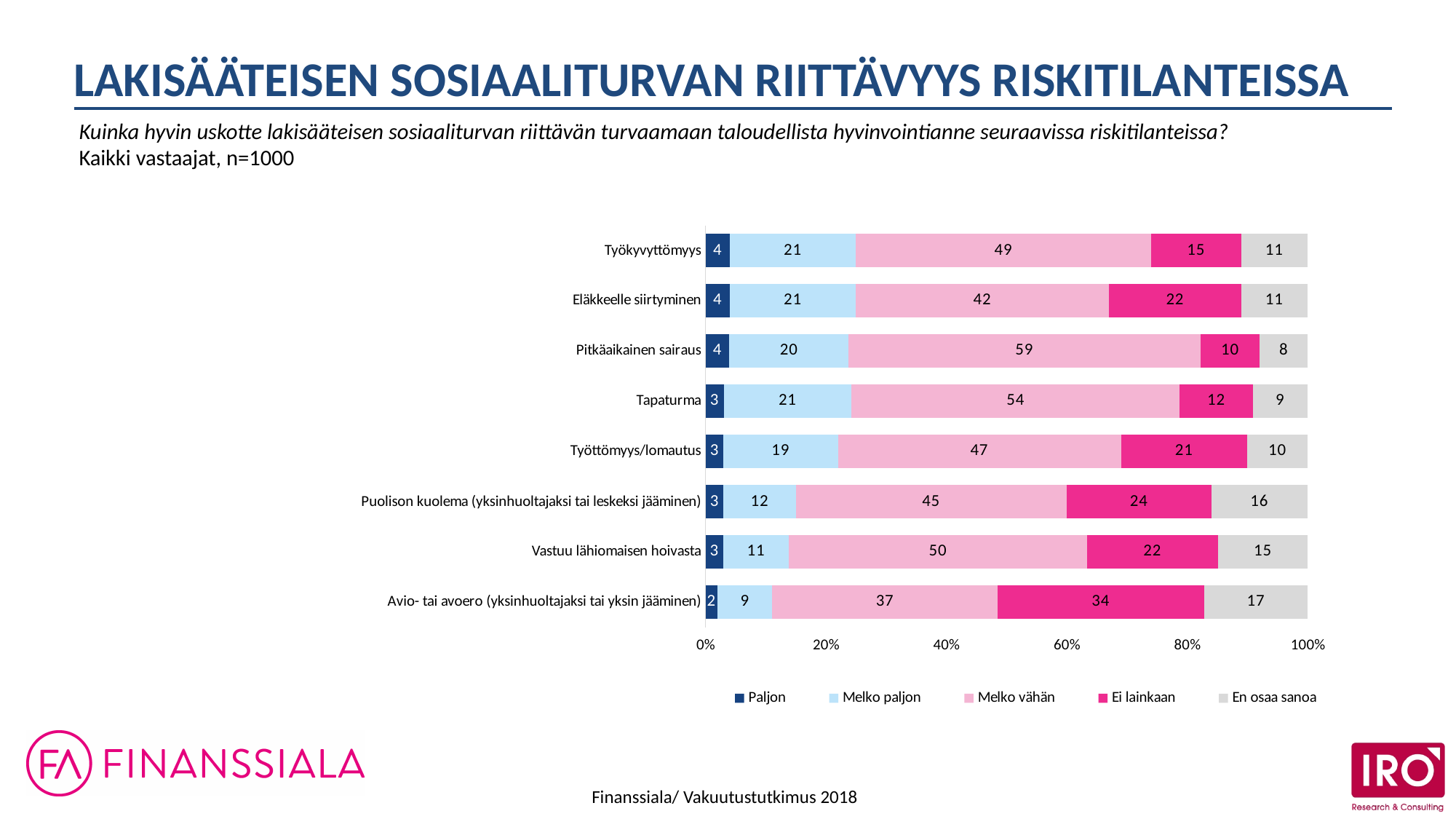
How many categories are shown on the chart? 8 What is the value of "En osaa sanoa" for Puolison kuolema (yksinhuoltajaksi tai leskeksi jääminen)? 16 What is the difference between the "Melko vähän" values for Pitkäaikainen sairaus and Eläkkeelle siirtyminen? 17 How many series does the legend list? 5 What kind of chart is shown on the slide? Stacked bar chart Which legend entry is shown in dark blue? Paljon What is the total of the "Paljon" and "Melko paljon" values for Tapaturma? 24 Which is larger: the "Ei lainkaan" value for Työkyvyttömyys or for Eläkkeelle siirtyminen? Eläkkeelle siirtyminen What is the value of "Melko vähän" for Pitkäaikainen sairaus? 59 What is the value of "Ei lainkaan" for Avio- tai avoero (yksinhuoltajaksi tai yksin jäämiseen)? 34 Which category has the lowest "Melko vähän" value? Avio- tai avoero (yksinhuoltajaksi tai yksin jääminen) Which category has the highest "Ei lainkaan" value? Avio- tai avoero (yksinhuoltajaksi tai yksin jääminen)